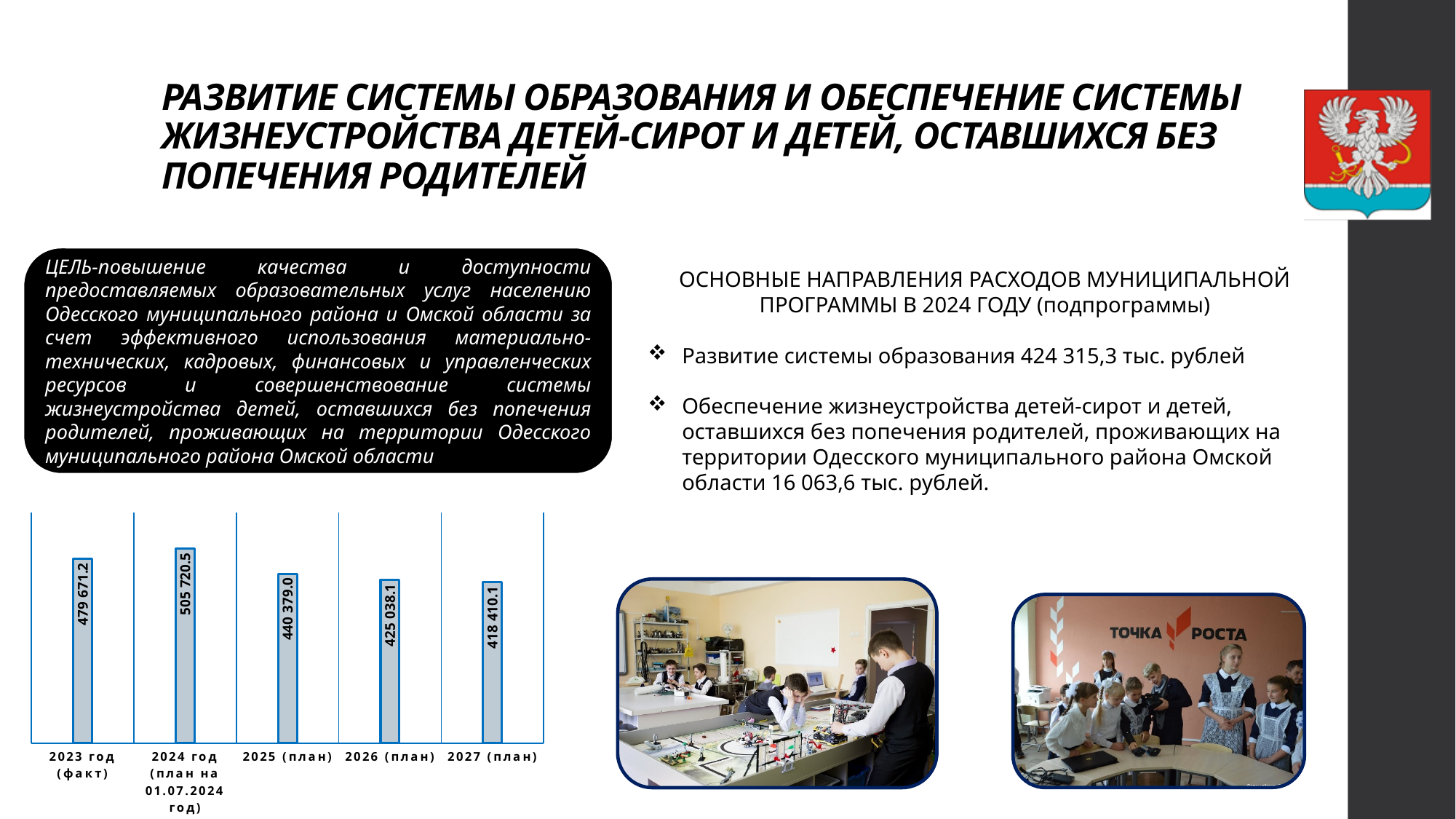
Which category has the lowest value? 2027 (план) What is the difference between the values for 2024 год (план на 01.07.2024 год) and 2023 год (факт)? 26 049.3 What is the value shown for 2025 (план)? 440 379.0 Which category has the highest value? 2024 год (план на 01.07.2024 год) What is the value shown for 2027 (план)? 418 410.1 What is the value shown for 2024 год (план на 01.07.2024 год)? 505 720.5 Which is larger, the value for 2025 (план) or the value for 2026 (план)? 2025 (план) What is the value shown for 2023 год (факт)? 479 671.2 How many categories are shown on the x axis of the chart? 5 Do the values rise or fall from 2024 год (план на 01.07.2024 год) to 2027 (план)? fall What kind of chart is shown on the slide? bar chart What is the difference between the values for 2026 (план) and 2027 (план)? 6 628.0